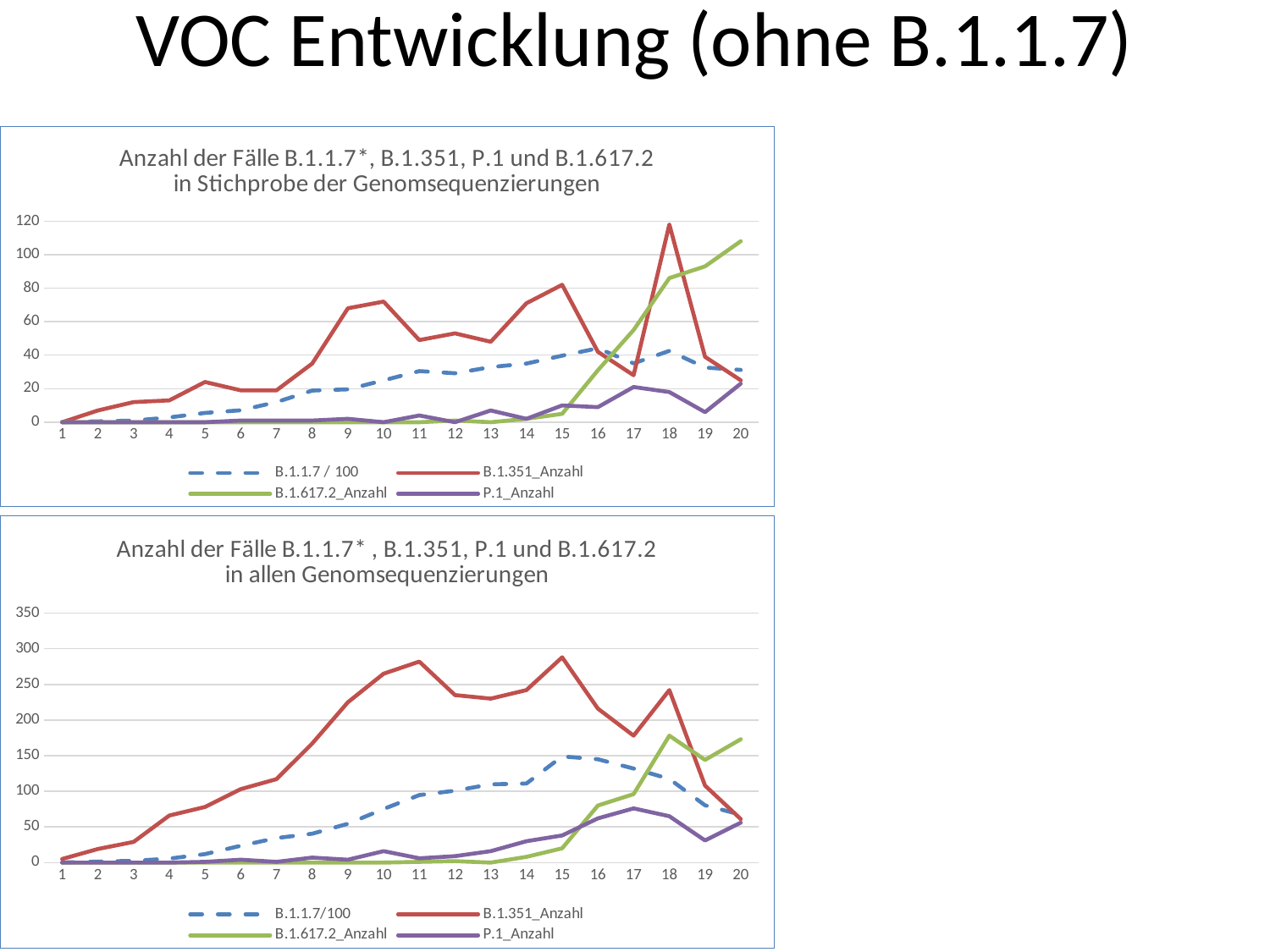
In the bottom chart ('in allen Genomsequenzierungen'), is the value of B.1.351_Anzahl at point 15 greater or less than 250? greater In the bottom chart ('in allen Genomsequenzierungen'), does B.1.617.2_Anzahl rise or fall from point 14 to point 18? rise How many series does the legend of the bottom chart ('in allen Genomsequenzierungen') list? 4 In the bottom chart ('in allen Genomsequenzierungen'), which series is shown as a dashed line according to the legend? B.1.1.7/100 How many series does the legend of the top chart ('in Stichprobe der Genomsequenzierungen') list? 4 What kind of chart is the top chart, 'in Stichprobe der Genomsequenzierungen'? Line chart How many points are on the x axis of the top chart ('in Stichprobe der Genomsequenzierungen')? 20 In the top chart ('in Stichprobe der Genomsequenzierungen'), which series has the highest value at point 20? B.1.617.2_Anzahl In the top chart ('in Stichprobe der Genomsequenzierungen'), is the value of B.1.617.2_Anzahl at point 20 greater or less than 100? greater In the bottom chart ('in allen Genomsequenzierungen'), which series reaches the highest value anywhere on the chart? B.1.351_Anzahl In the top chart ('in Stichprobe der Genomsequenzierungen'), is the value of B.1.351_Anzahl at point 18 greater or less than 100? greater In the top chart ('in Stichprobe der Genomsequenzierungen'), at point 18, which is larger: B.1.351_Anzahl or B.1.617.2_Anzahl? B.1.351_Anzahl